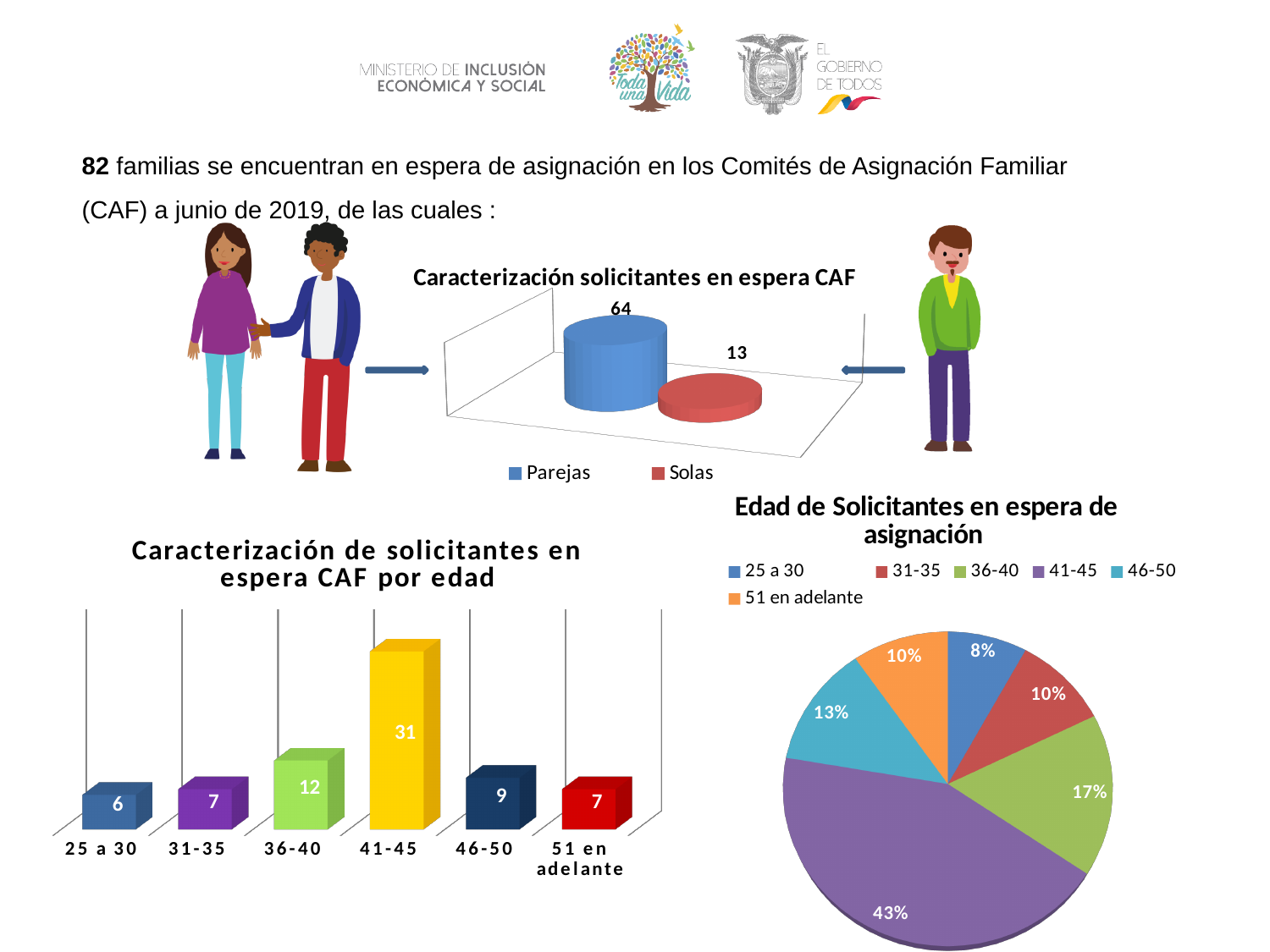
In the chart titled 'Caracterización de solicitantes en espera CAF por edad', what is the value for 36-40? 12 In the pie chart titled 'Edad de Solicitantes en espera de asignación', what share does 41-45 have? 43% In the chart titled 'Caracterización de solicitantes en espera CAF por edad', what is the value for 41-45? 31 What kind of chart is 'Caracterización de solicitantes en espera CAF por edad'? bar chart In the chart titled 'Caracterización de solicitantes en espera CAF por edad', what is the difference between 41-45 and 46-50? 22 In the pie chart titled 'Edad de Solicitantes en espera de asignación', how many categories does the legend list? 6 In the pie chart titled 'Edad de Solicitantes en espera de asignación', what share does 36-40 have? 17% In the chart titled 'Caracterización de solicitantes en espera CAF por edad', which age group has the lowest value? 25 a 30 In the chart titled 'Caracterización solicitantes en espera CAF', what is the difference between Parejas and Solas? 51 In the chart titled 'Caracterización solicitantes en espera CAF', what is the value for Parejas? 64 In the chart titled 'Caracterización de solicitantes en espera CAF por edad', how many age categories are shown? 6 In the chart titled 'Caracterización solicitantes en espera CAF', what is the value for Solas? 13